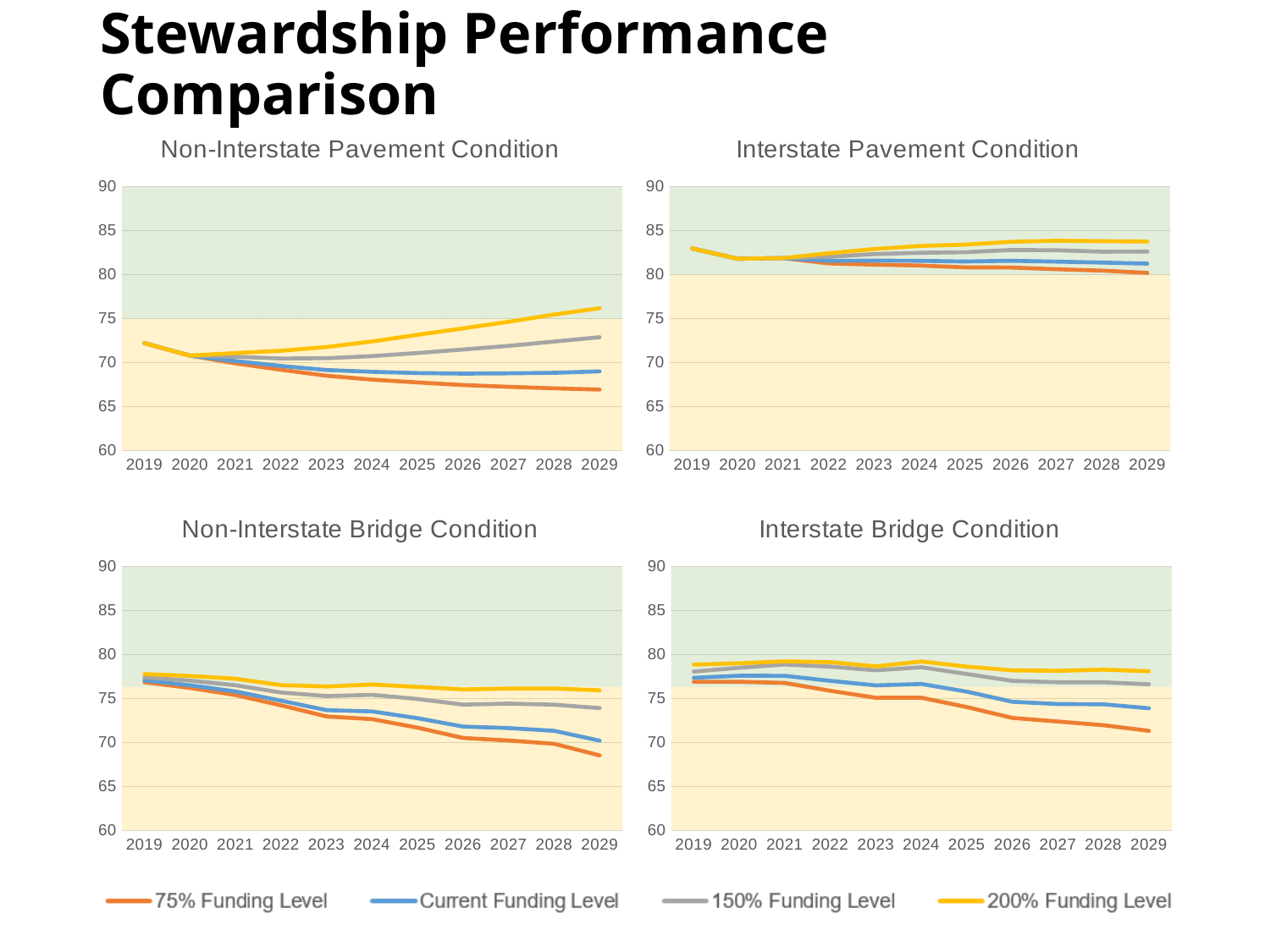
How many years are plotted along the x axis of the Interstate Bridge Condition chart? 11 In the Non-Interstate Pavement Condition chart, does the 200% Funding Level line rise or fall from 2020 to 2029? rise What colour is the 200% Funding Level line in the charts? yellow In the Non-Interstate Pavement Condition chart, is the 200% Funding Level value in 2029 greater or less than 75? greater In the Interstate Pavement Condition chart, which is larger in 2029: the Current Funding Level value or the 75% Funding Level value? Current Funding Level In the Interstate Bridge Condition chart, does the 75% Funding Level line rise or fall from 2019 to 2029? fall What kind of chart is the Non-Interstate Pavement Condition chart? line chart How many series does the legend at the bottom of the slide list? 4 In the Non-Interstate Pavement Condition chart, which funding level has the lowest value in 2029? 75% Funding Level In the Non-Interstate Bridge Condition chart, is the 75% Funding Level value in 2029 greater or less than 70? less In the Non-Interstate Pavement Condition chart, does the 75% Funding Level line rise or fall from 2019 to 2029? fall In the Interstate Bridge Condition chart, which funding level has the highest value in 2029? 200% Funding Level